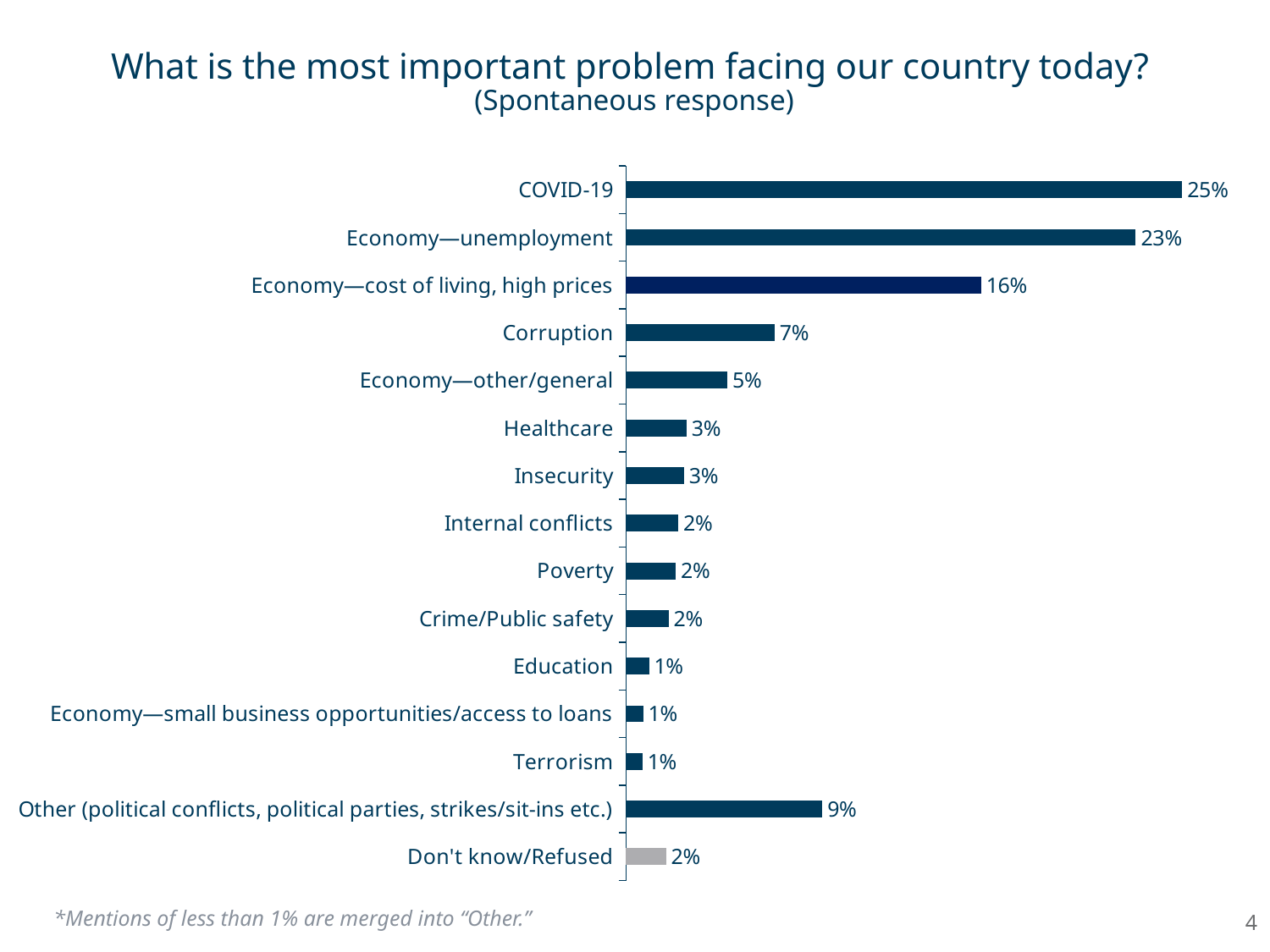
What is the value for Economy—cost of living, high prices? 16% What is the difference between the values for Economy—unemployment and Economy—cost of living, high prices? 7% What percentage of respondents named COVID-19 as the most important problem? 25% What is the value for Don't know/Refused? 2% Which is larger, the value for Economy—other/general or the value for Healthcare? Economy—other/general What is the value for Corruption? 7% Which category has the highest value? COVID-19 Which bar is shown in grey rather than dark blue? Don't know/Refused What is the difference between the values for COVID-19 and Economy—unemployment? 2% What kind of chart is shown on the slide? Bar chart Which is larger, the value for Corruption or the value for Other (political conflicts, political parties, strikes/sit-ins etc.)? Other (political conflicts, political parties, strikes/sit-ins etc.) How many categories are shown in the chart? 15